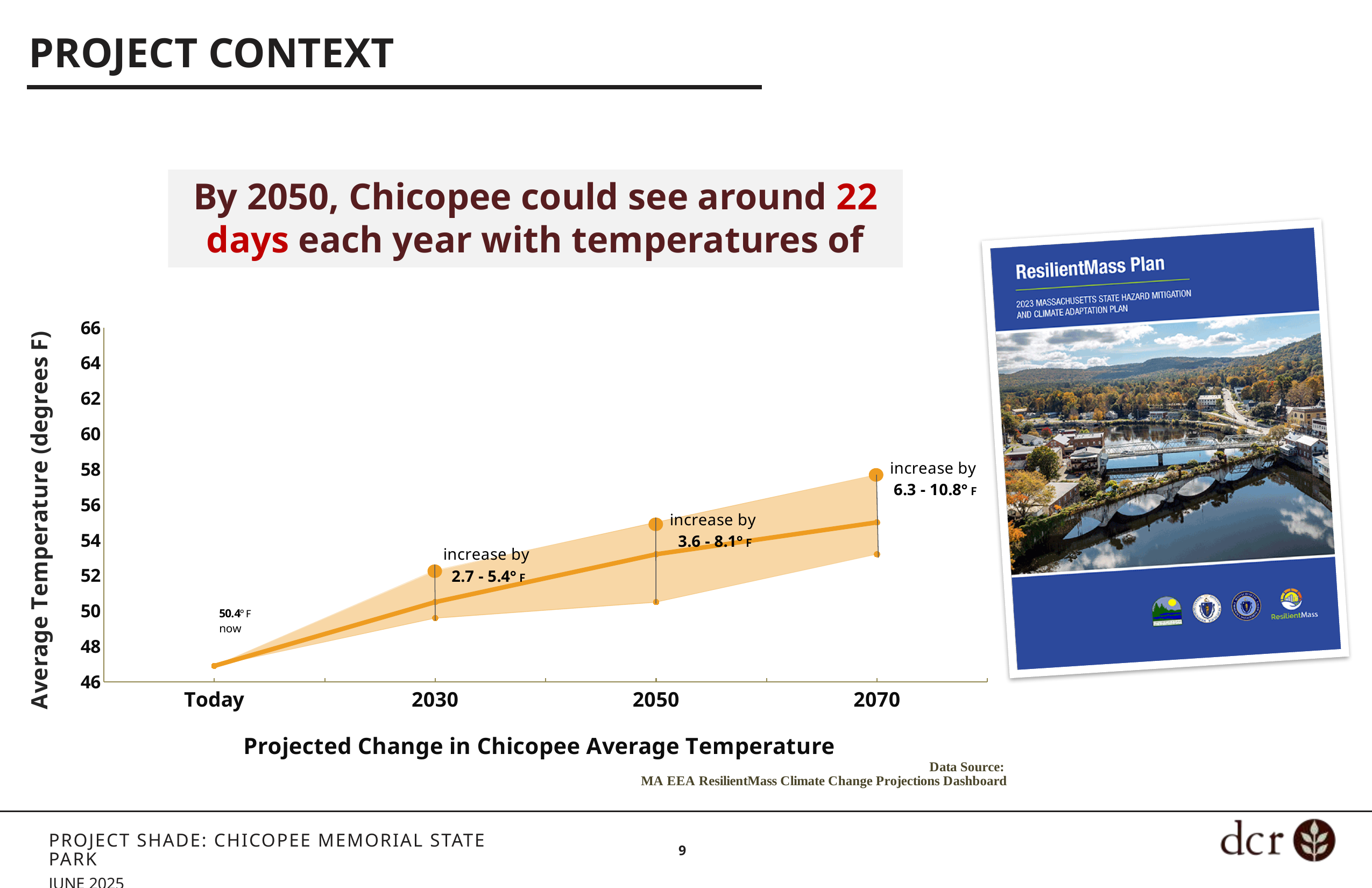
Do the projected average temperatures rise or fall from Today to 2070? rise By how much is the average temperature projected to increase by 2030, according to the chart label? 2.7 - 5.4° F Is the projected average temperature line for 2030 greater or less than 52? less What kind of chart is shown on the slide? line chart Which time point has the lowest average temperature on the chart? Today By how much is the average temperature projected to increase by 2050, according to the chart label? 3.6 - 8.1° F Which time point has the highest projected average temperature? 2070 By how much is the average temperature projected to increase by 2070, according to the chart label? 6.3 - 10.8° F How many time points are plotted along the x axis of the chart? 4 What is the current (Today) average temperature shown on the chart? 50.4° F What is the title of the chart? Projected Change in Chicopee Average Temperature Which has a higher projected average temperature on the line, 2030 or 2050? 2050